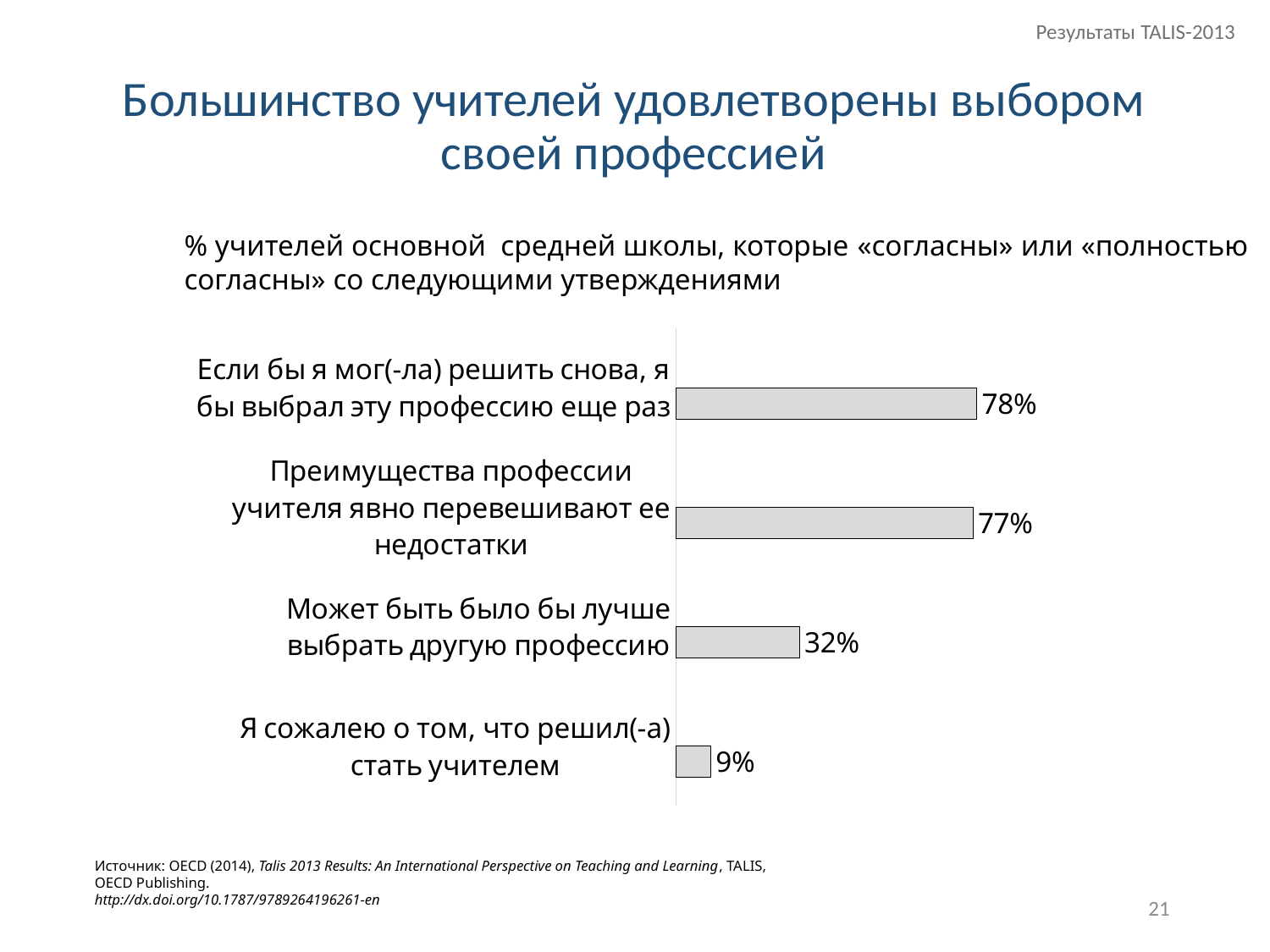
Which is larger: the value for "Преимущества профессии учителя явно перевешивают ее недостатки" or the value for "Может быть было бы лучше выбрать другую профессию"? Преимущества профессии учителя явно перевешивают ее недостатки How many statements are shown in the chart? 4 What percentage of teachers agree that "Может быть было бы лучше выбрать другую профессию"? 32% What is the difference between the values for "Может быть было бы лучше выбрать другую профессию" and "Я сожалею о том, что решил(-а) стать учителем"? 23% What percentage of teachers agree with the statement "Если бы я мог(-ла) решить снова, я бы выбрал эту профессию еще раз"? 78% What is the value for "Я сожалею о том, что решил(-а) стать учителем"? 9% What is the title of the slide containing the chart? Большинство учителей удовлетворены выбором своей профессией What is the value shown for "Преимущества профессии учителя явно перевешивают ее недостатки"? 77% Which statement has the highest percentage of agreement? Если бы я мог(-ла) решить снова, я бы выбрал эту профессию еще раз What is the difference between the values for "Если бы я мог(-ла) решить снова, я бы выбрал эту профессию еще раз" and "Может быть было бы лучше выбрать другую профессию"? 46% Which statement has the lowest percentage of agreement? Я сожалею о том, что решил(-а) стать учителем What kind of chart is shown on the slide? Bar chart